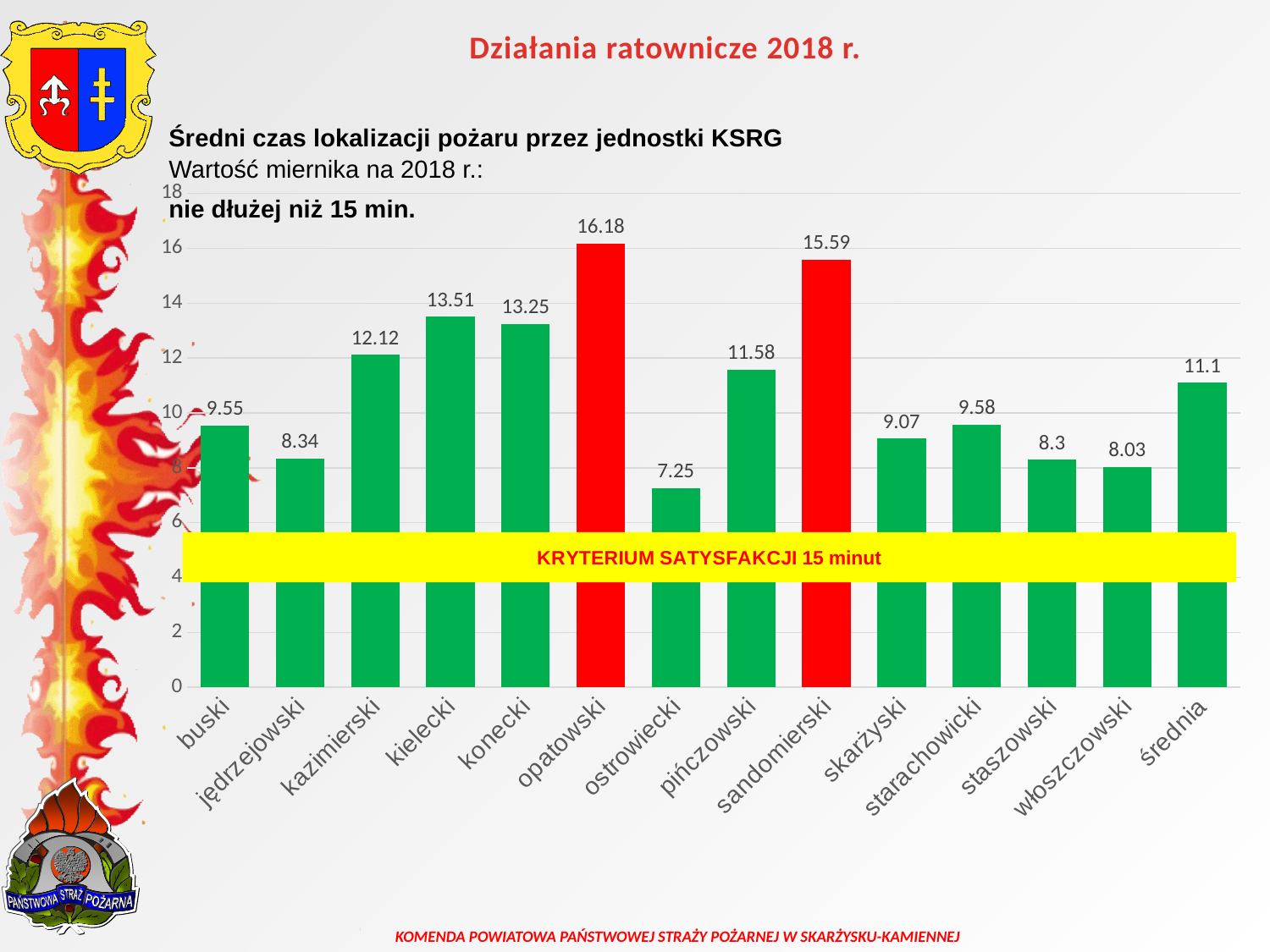
What is the value for ostrowiecki? 7.25 What is the value for opatowski? 16.18 What is the difference between the values for opatowski and sandomierski? 0.59 What is the value for the średnia bar? 11.1 How many bars are shown in the chart? 14 What text is written on the yellow band across the chart? KRYTERIUM SATYSFAKCJI 15 minut Which category has the highest value? opatowski Is the value for sandomierski greater or less than 14? greater Which is larger, the value for kazimierski or the value for pińczowski? kazimierski Which category has the lowest value? ostrowiecki What kind of chart is shown on the slide? bar chart What is the difference between the values for kielecki and konecki? 0.26